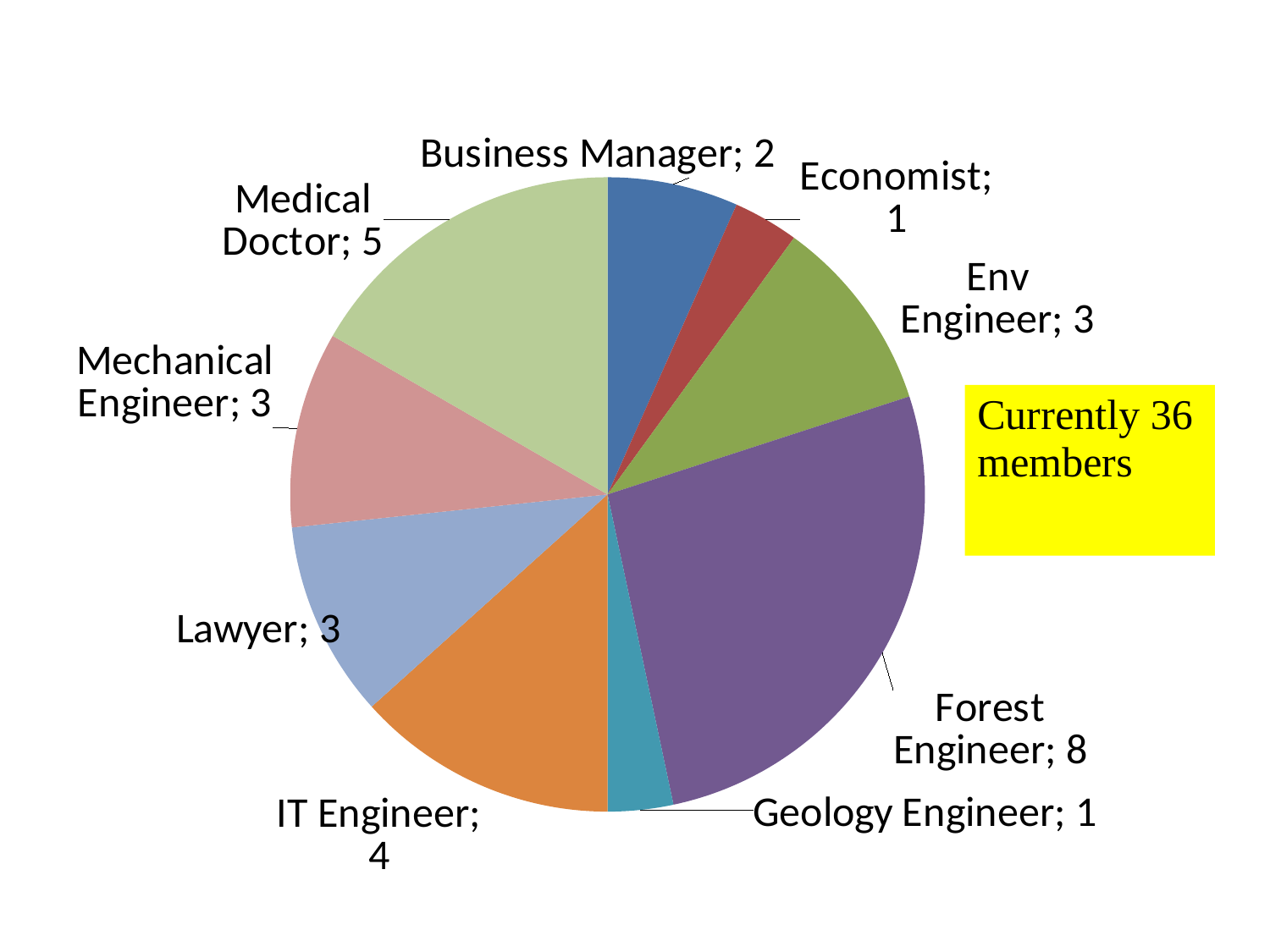
Which is larger, the value for Lawyer or the value for Medical Doctor? Medical Doctor Which category has the largest slice of the pie? Forest Engineer Which two categories have the smallest value in the pie chart? Economist and Geology Engineer What is the value for IT Engineer? 4 What is the difference between the values for Forest Engineer and Medical Doctor? 3 What is the difference between the values for IT Engineer and Business Manager? 2 What is the value for Forest Engineer? 8 How many slices does the pie chart have? 9 What kind of chart is shown on the slide? pie chart What does the yellow text box on the slide say? Currently 36 members What is the value for Business Manager? 2 What is the value for Medical Doctor? 5